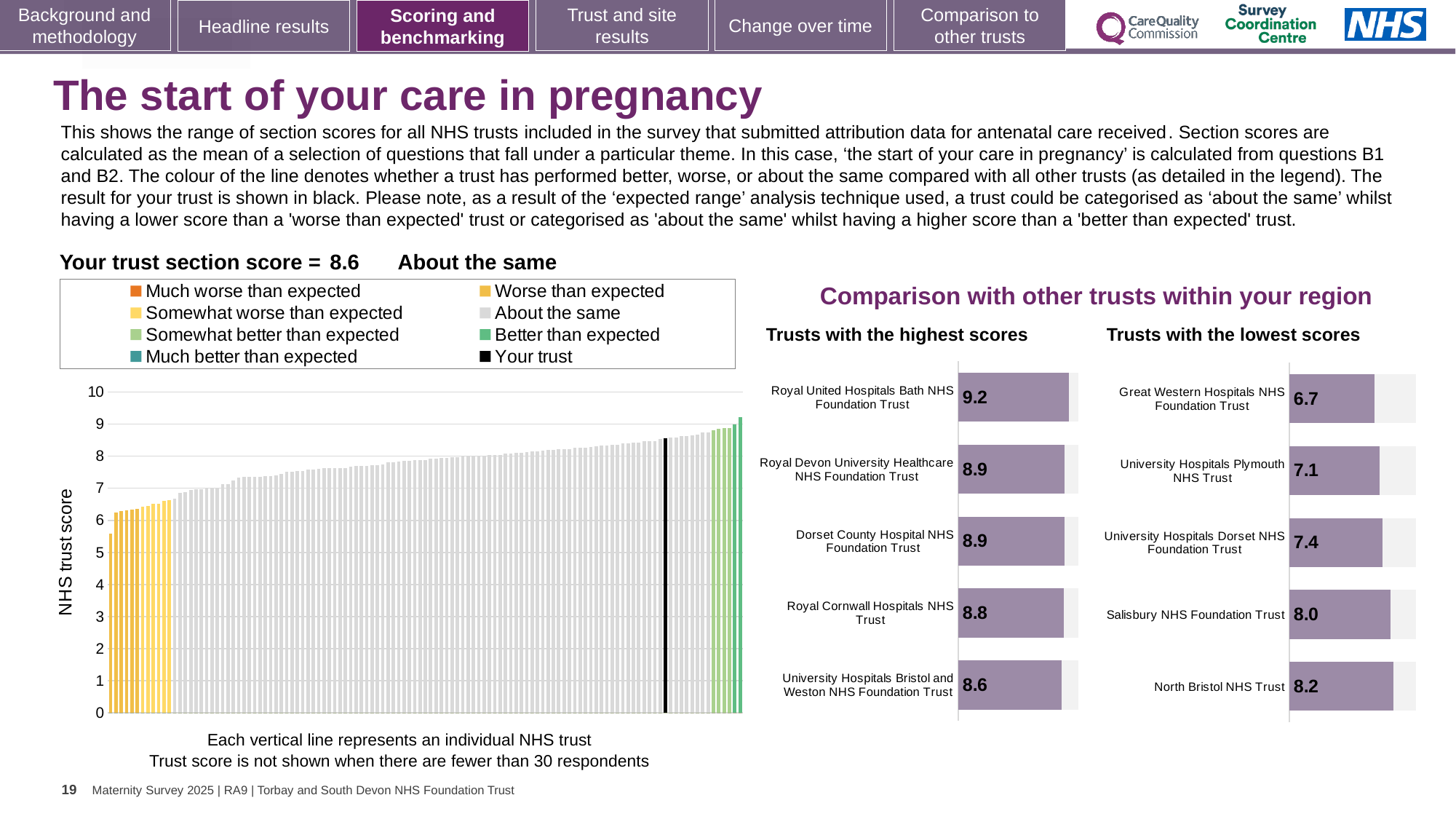
In the 'Trusts with the highest scores' chart, which trust has the highest score? Royal United Hospitals Bath NHS Foundation Trust In the 'Trusts with the lowest scores' chart, what is the difference between the scores of North Bristol NHS Trust and Great Western Hospitals NHS Foundation Trust? 1.5 In the 'Trusts with the highest scores' chart, what is the score for Royal United Hospitals Bath NHS Foundation Trust? 9.2 In the 'Trusts with the lowest scores' chart, which trust has the lowest score? Great Western Hospitals NHS Foundation Trust In the 'Trusts with the lowest scores' chart, which has the higher score: Salisbury NHS Foundation Trust or University Hospitals Dorset NHS Foundation Trust? Salisbury NHS Foundation Trust In the 'Trusts with the lowest scores' chart, what is the score for Great Western Hospitals NHS Foundation Trust? 6.7 What kind of chart is the large chart on the left showing NHS trust scores? Bar chart What is the label on the vertical axis of the large chart on the left? NHS trust score In the large chart on the left, is the value for the lowest-scoring trust greater or less than 7? less In the large chart on the left, do the trust scores rise or fall from left to right? Rise In the 'Trusts with the highest scores' chart, what is the difference between the scores of Royal United Hospitals Bath NHS Foundation Trust and University Hospitals Bristol and Weston NHS Foundation Trust? 0.6 How many trusts are shown in the 'Trusts with the highest scores' chart? 5